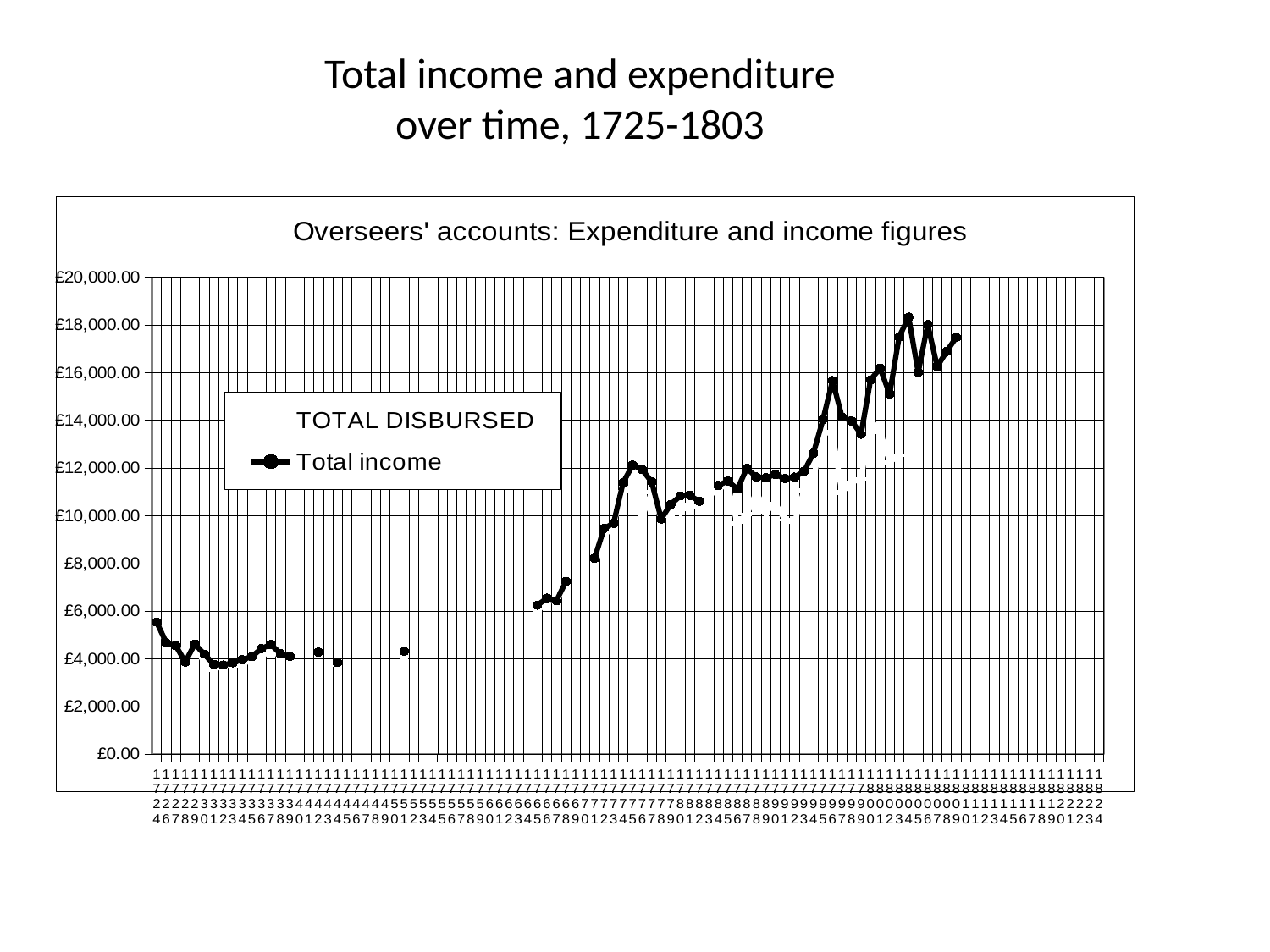
Is the peak plotted value in the 1770s greater or less than £10,000.00? greater Do the plotted values generally rise or fall from left to right along the x axis? rise What kind of chart is shown on the slide? line chart What are the two entries in the chart legend? TOTAL DISBURSED and Total income Is the first plotted value at the left of the chart greater or less than £6,000.00? less Are the plotted values in the 1790s greater or less than £8,000.00? greater What is the title printed inside the chart area? Overseers' accounts: Expenditure and income figures How many series does the chart legend list? 2